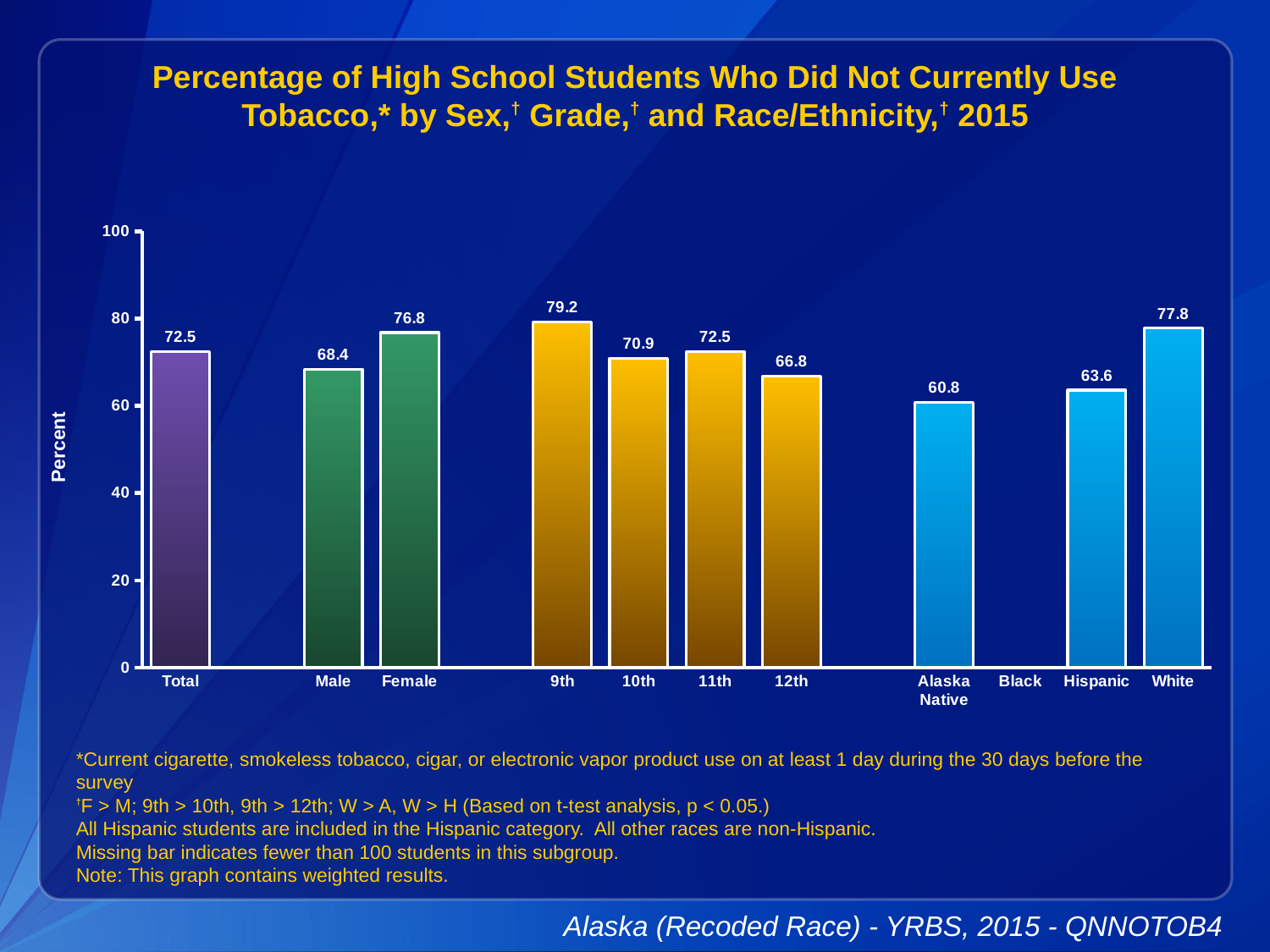
Which category label has no bar plotted? Black What kind of chart is shown? bar chart How many bars are plotted on the chart? 10 What is the value for 12th grade? 66.8 What is the label on the y axis? Percent Is the value for 10th grade greater or less than 80? less What is the value for Alaska Native? 60.8 Which category has the highest value? 9th What is the value for Female? 76.8 What is the difference between the Female and Male values? 8.4 Which is larger, the value for White or the value for Hispanic? White Which category has the lowest value? Alaska Native